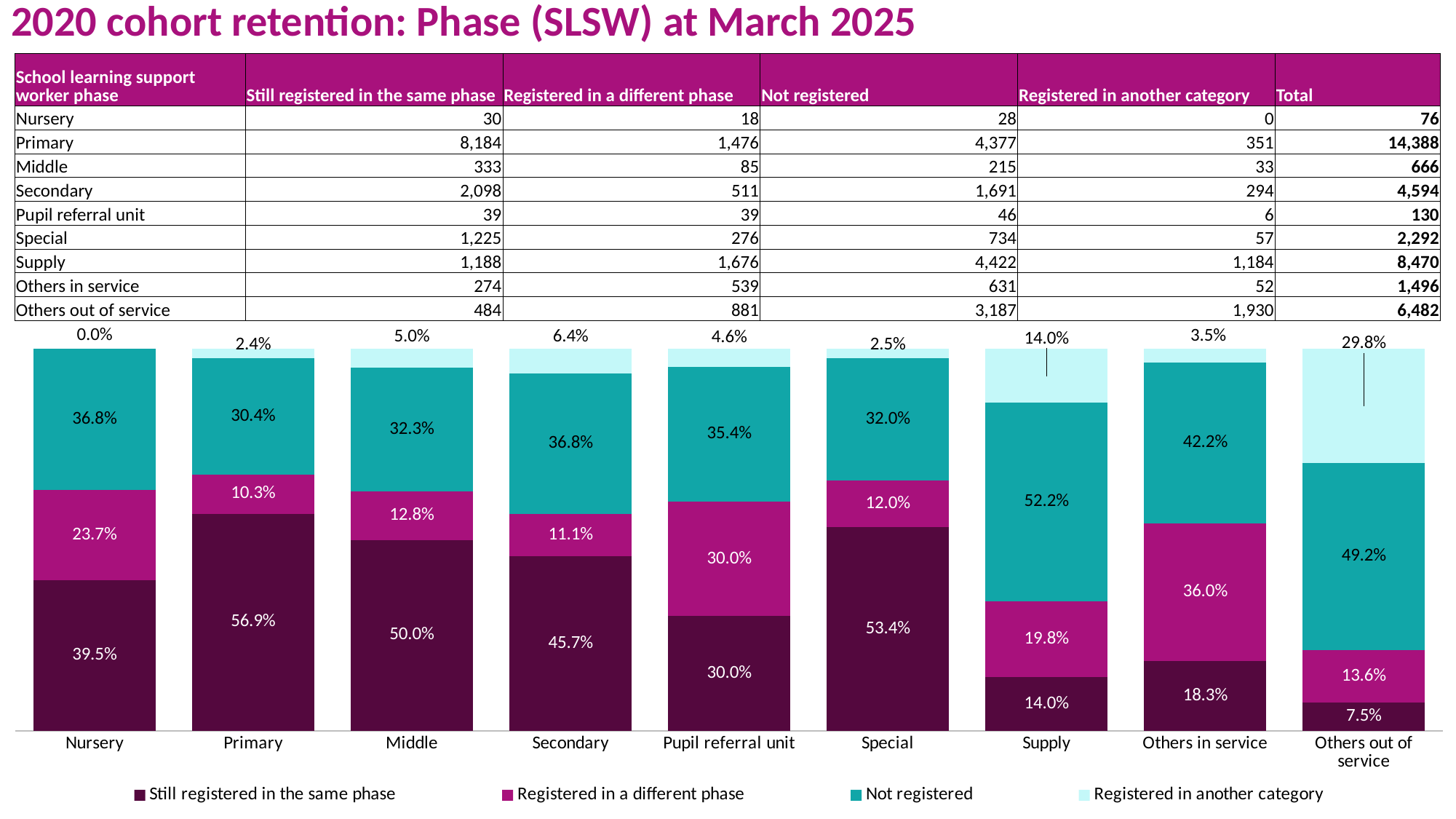
How many series does the legend of the stacked bar chart list? 4 In the stacked bar chart, what is the 'Registered in another category' percentage for Others out of service? 29.8% In the stacked bar chart, which phase has the highest percentage still registered in the same phase? Primary In the stacked bar chart, which has the larger 'Registered in a different phase' share: Pupil referral unit or Special? Pupil referral unit What type of chart is shown below the table on the slide? Stacked bar chart In the stacked bar chart, what percentage of the Primary cohort is still registered in the same phase? 56.9% In the stacked bar chart, which phase has the highest 'Not registered' percentage? Supply In the stacked bar chart, what is the 'Registered in another category' percentage for Nursery? 0.0% In the stacked bar chart, what is the 'Not registered' percentage for Supply? 52.2% How many phase categories are shown along the x axis of the stacked bar chart? 9 In the stacked bar chart, which phase has the lowest percentage still registered in the same phase? Others out of service In the stacked bar chart, what is the difference in percentage points between the 'Not registered' share for Others in service and for Nursery? 5.4 percentage points